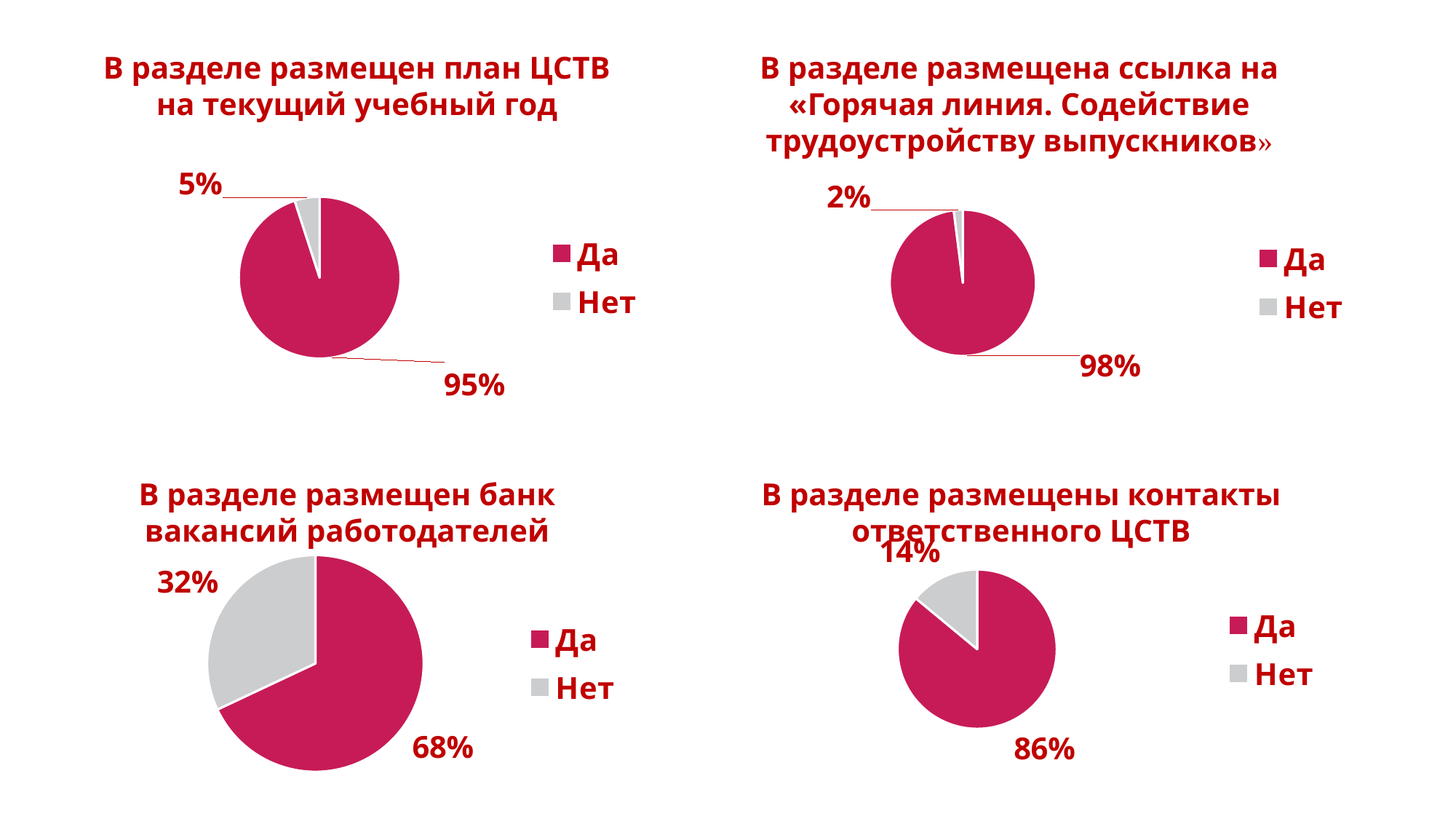
In the bottom-left chart 'В разделе размещен банк вакансий работодателей', what is the difference between the 'Да' and 'Нет' shares? 36% In the bottom-right chart 'В разделе размещены контакты ответственного ЦСТВ', which slice is the smallest? Нет In the bottom-right chart 'В разделе размещены контакты ответственного ЦСТВ', which is larger, 'Да' or 'Нет'? Да In the top-right chart 'В разделе размещена ссылка на «Горячая линия. Содействие трудоустройству выпускников»', what share is labelled for 'Да'? 98% In the bottom-left chart 'В разделе размещен банк вакансий работодателей', what share is labelled for 'Нет'? 32% What type of chart is the top-left chart 'В разделе размещен план ЦСТВ на текущий учебный год'? Pie chart How many entries does the legend of the top-right chart 'В разделе размещена ссылка на «Горячая линия. Содействие трудоустройству выпускников»' list? 2 In the bottom-left chart 'В разделе размещен банк вакансий работодателей', which slice is the largest? Да In the bottom-right chart 'В разделе размещены контакты ответственного ЦСТВ', what share is labelled for 'Да'? 86% In the top-left chart 'В разделе размещен план ЦСТВ на текущий учебный год', what share is labelled for 'Да'? 95% In the top-right chart 'В разделе размещена ссылка на «Горячая линия. Содействие трудоустройству выпускников»', what share is labelled for 'Нет'? 2% In the top-left chart 'В разделе размещен план ЦСТВ на текущий учебный год', what share is labelled for 'Нет'? 5%